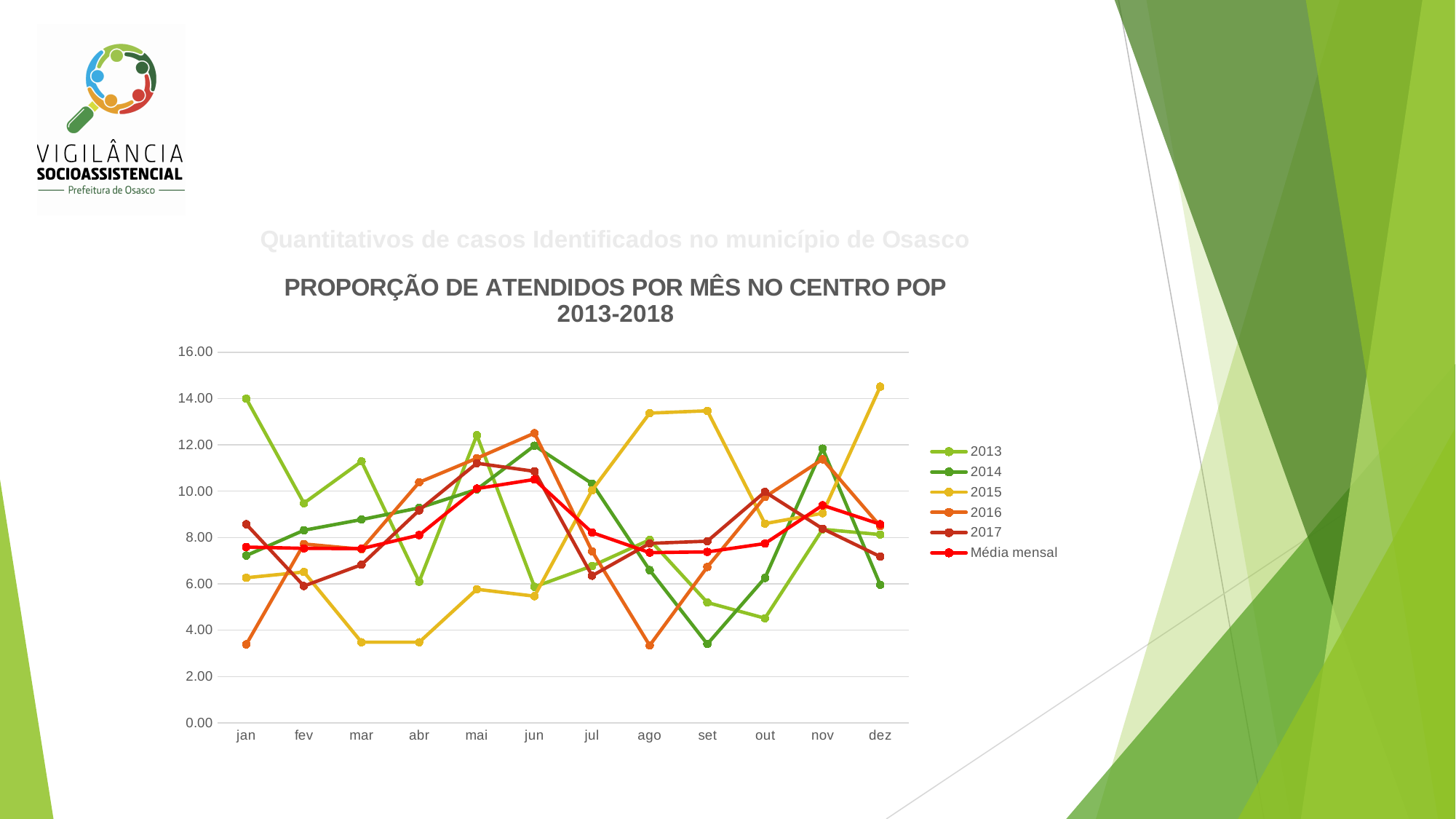
How many months are shown on the x axis? 12 In which month does the 2014 series reach its lowest value? set In which month does the 2013 series reach its highest value? jan Does the 2015 series rise or fall from jul to set? rise What kind of chart is shown on the slide? line chart Is the value for 2015 in dez greater or less than 12.00? greater How many series does the legend list? 6 Is the value for 2014 in set greater or less than 4.00? less Is the value for 2013 in jan greater or less than 12.00? greater In which month does the 2015 series reach its highest value? dez In jan, which series has the larger value, 2013 or 2014? 2013